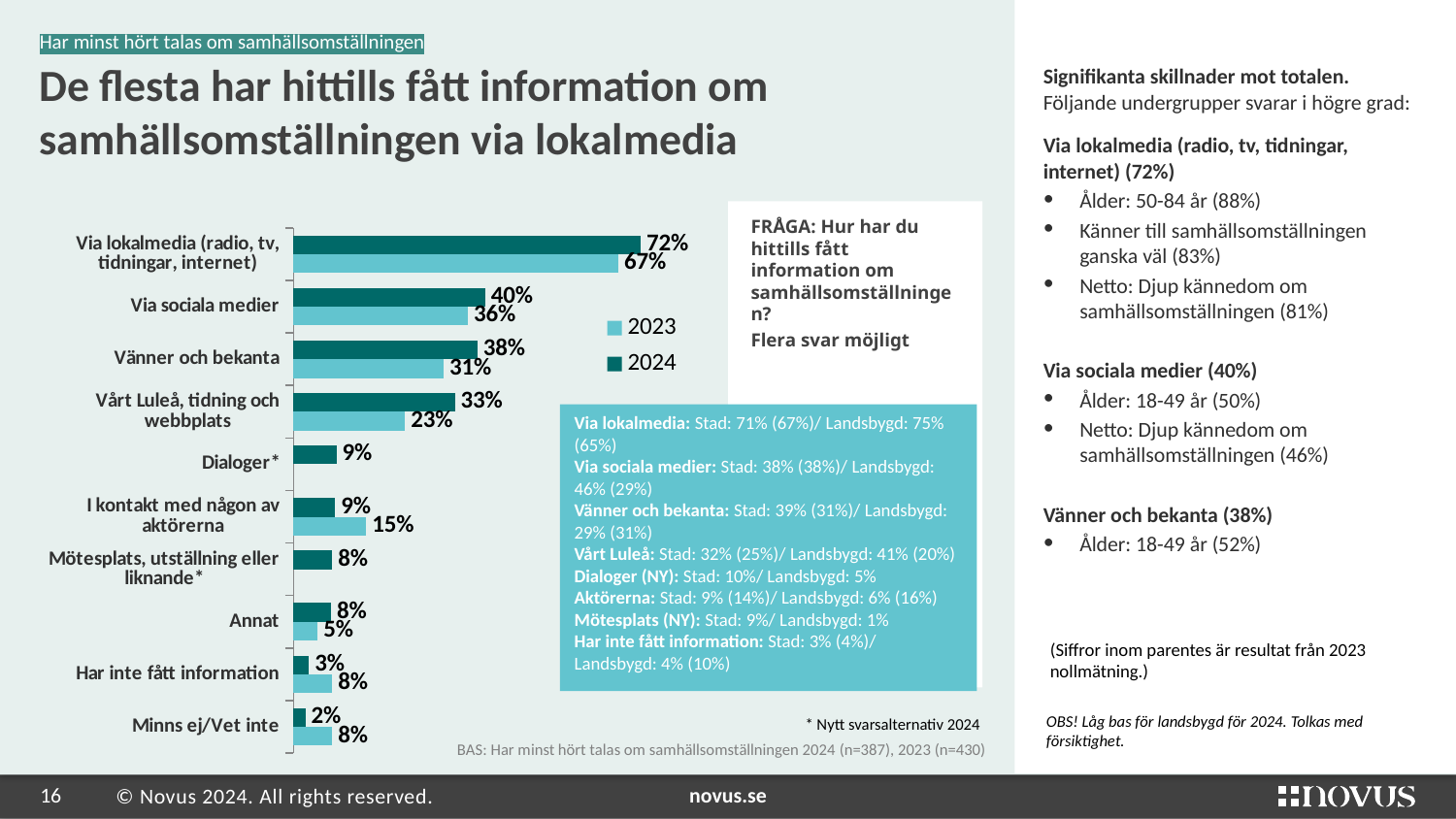
How many categories are shown on the chart? 10 What is the difference between the 2024 and 2023 values for 'Vänner och bekanta'? 7 percentage points What is the 2023 value for 'Via sociala medier'? 36% Which category has the highest 2024 value? Via lokalmedia (radio, tv, tidningar, internet) How many series does the chart legend list? 2 What is the 2024 value for 'Via lokalmedia (radio, tv, tidningar, internet)'? 72% What kind of chart is shown on the slide? bar chart For 'Har inte fått information', which year has the larger value, 2023 or 2024? 2023 What is the 2023 value for 'I kontakt med någon av aktörerna'? 15% Which colour represents the 2024 series in the chart? dark teal Which category has the lowest 2024 value? Minns ej/Vet inte What is the 2024 value for 'Vårt Luleå, tidning och webbplats'? 33%